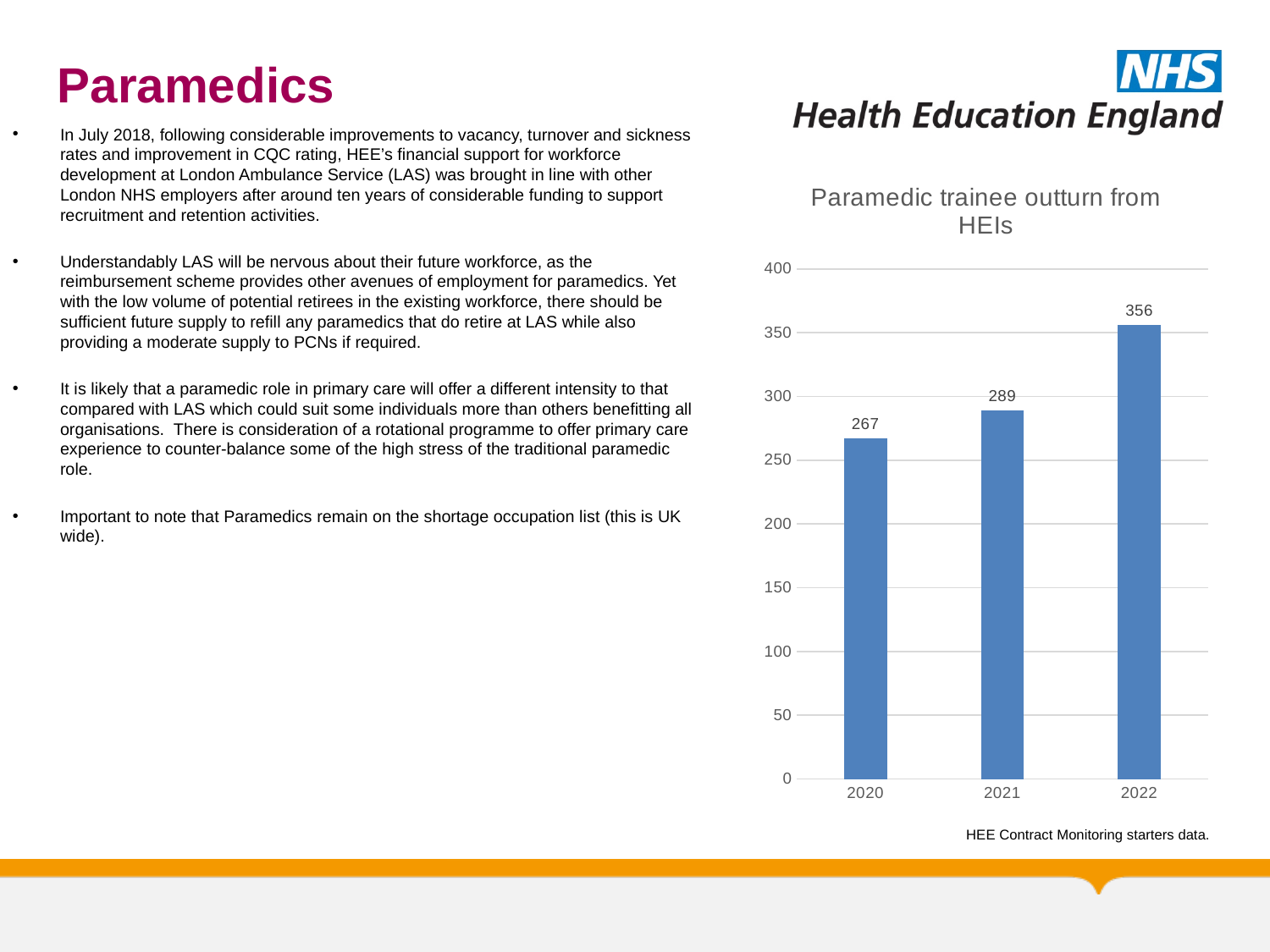
Which year has the highest paramedic trainee outturn from HEIs? 2022 What kind of chart is used to show the paramedic trainee outturn from HEIs? Bar chart Which year has the lowest paramedic trainee outturn from HEIs? 2020 What is the paramedic trainee outturn from HEIs for 2021? 289 How many years are shown on the paramedic trainee outturn chart? 3 What is the paramedic trainee outturn from HEIs for 2022? 356 Does the paramedic trainee outturn from HEIs rise or fall from 2020 to 2022? Rise Is the paramedic trainee outturn for 2021 greater or less than 300? less Which year has a larger paramedic trainee outturn, 2021 or 2022? 2022 What is the paramedic trainee outturn from HEIs for 2020? 267 What is the difference between the paramedic trainee outturn in 2022 and in 2020? 89 What is the difference between the paramedic trainee outturn in 2021 and in 2020? 22